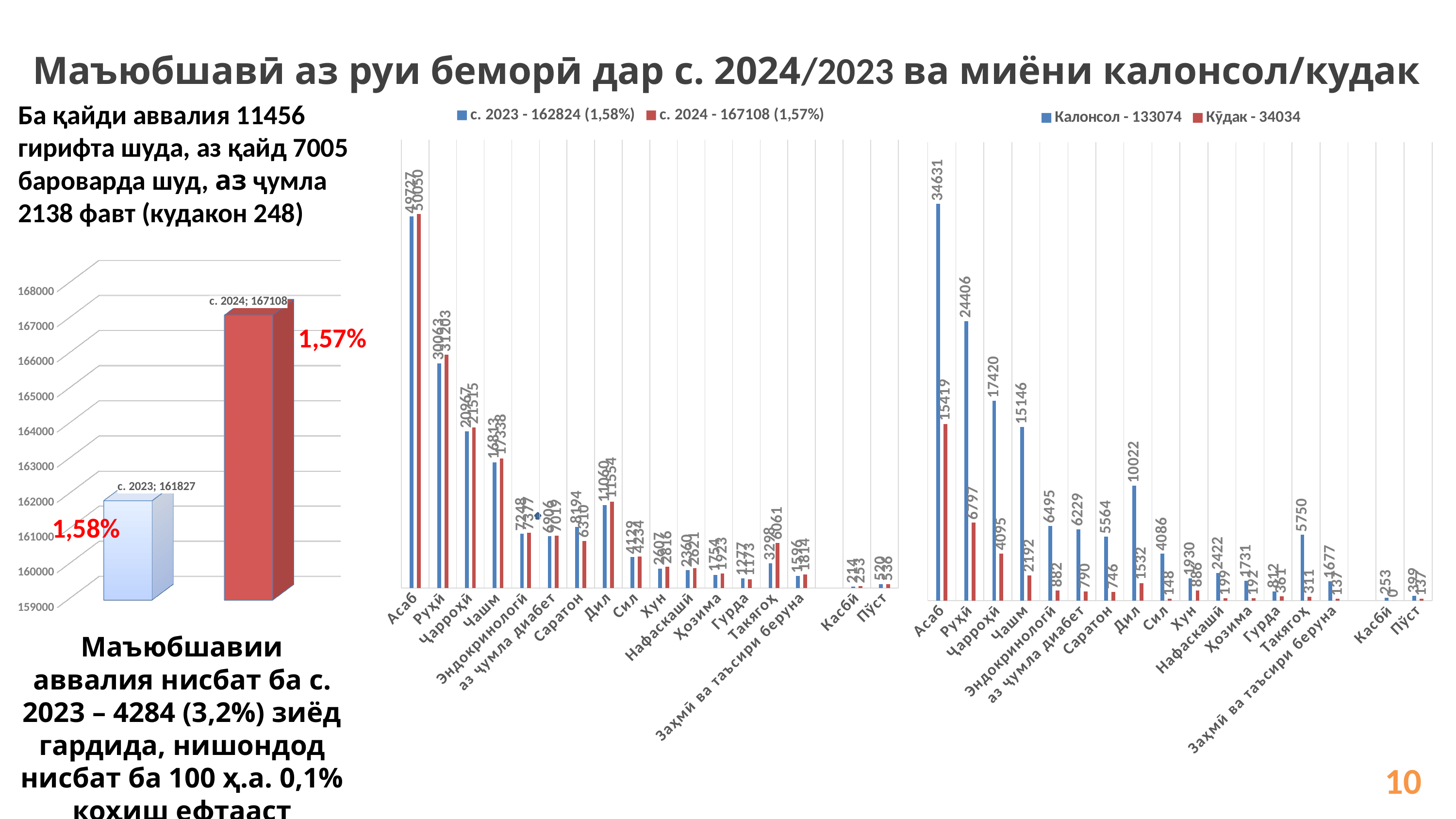
In the middle chart (с. 2023 / с. 2024), which series has the larger value for Такягоҳ? с. 2024 How many series does the legend of the right chart (Калонсол / Кӯдак) list? 2 In the left 3D bar chart, what value is shown for с. 2024? 167108 In the left 3D bar chart, what percentage is printed in red next to the с. 2023 bar? 1,58% In the right chart (Калонсол / Кӯдак), what is the difference between the Калонсол and Кӯдак values for Ҷарроҳӣ? 13325 In the left 3D bar chart, what value is shown for с. 2023? 161827 In the right chart (Калонсол / Кӯдак), what is the Калонсол value for Дил? 10022 In the right chart (Калонсол / Кӯдак), which category has the highest Кӯдак value? Асаб In the right chart (Калонсол / Кӯдак), what is the Калонсол value for Такягоҳ? 5750 In the right chart (Калонсол / Кӯдак), what is the Калонсол value for Асаб? 34631 In the right chart (Калонсол / Кӯдак), what is the Кӯдак value for Руҳӣ? 6797 What kind of chart is the middle chart with the с. 2023 and с. 2024 series? Bar chart